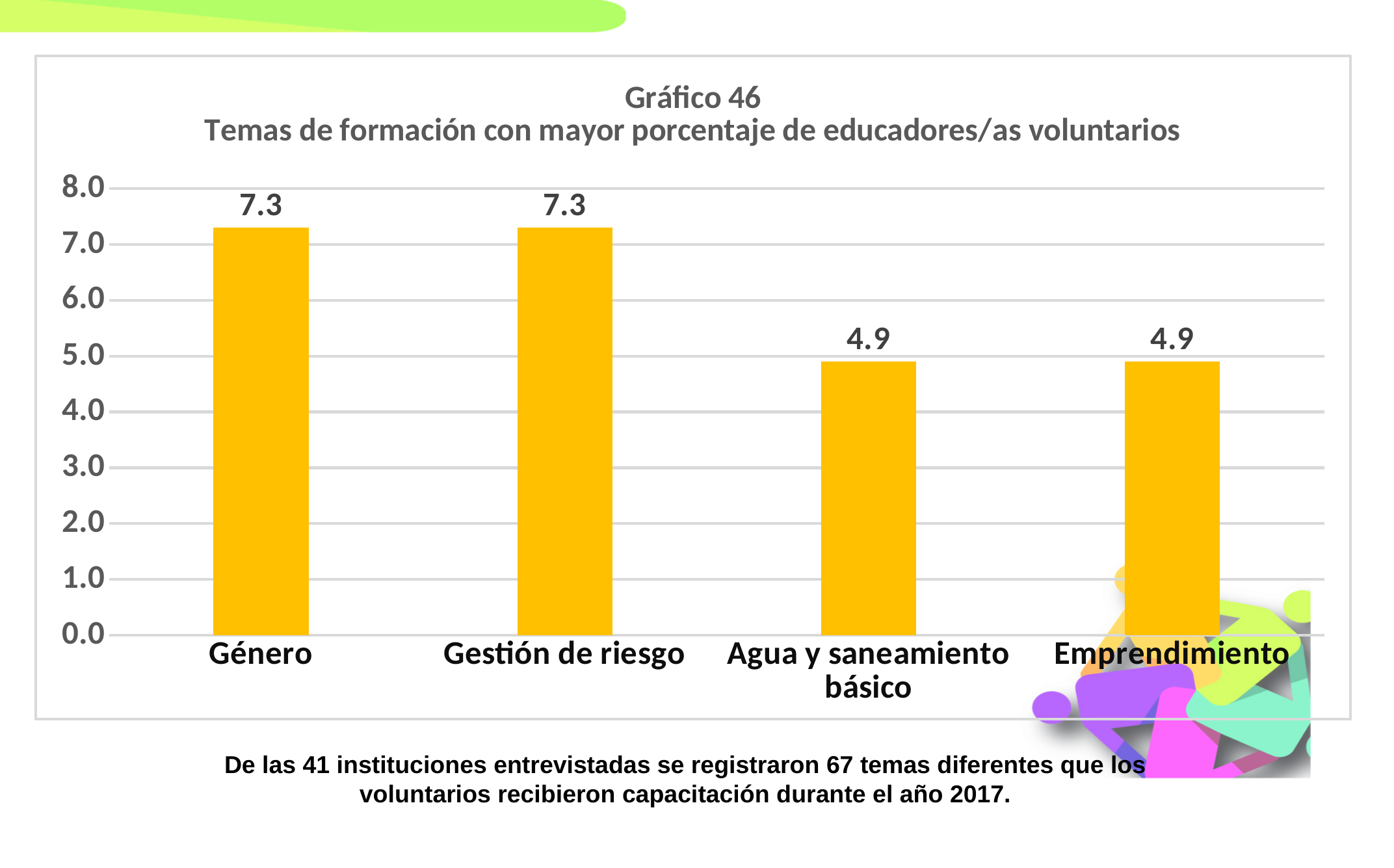
What is the value for Gestión de riesgo? 7.3 What colour are the bars in the chart? yellow What is the title of the chart? Gráfico 46 Temas de formación con mayor porcentaje de educadores/as voluntarios What is the value for Emprendimiento? 4.9 What is the value for Género? 7.3 What is the difference between the value for Gestión de riesgo and the value for Agua y saneamiento básico? 2.4 What is the value for Agua y saneamiento básico? 4.9 How many categories are shown in the chart? 4 What kind of chart is shown on the slide? bar chart Is the value for Género greater or less than 7.0? greater Is the value for Agua y saneamiento básico greater or less than 5.0? less Which is larger, the value for Género or the value for Emprendimiento? Género